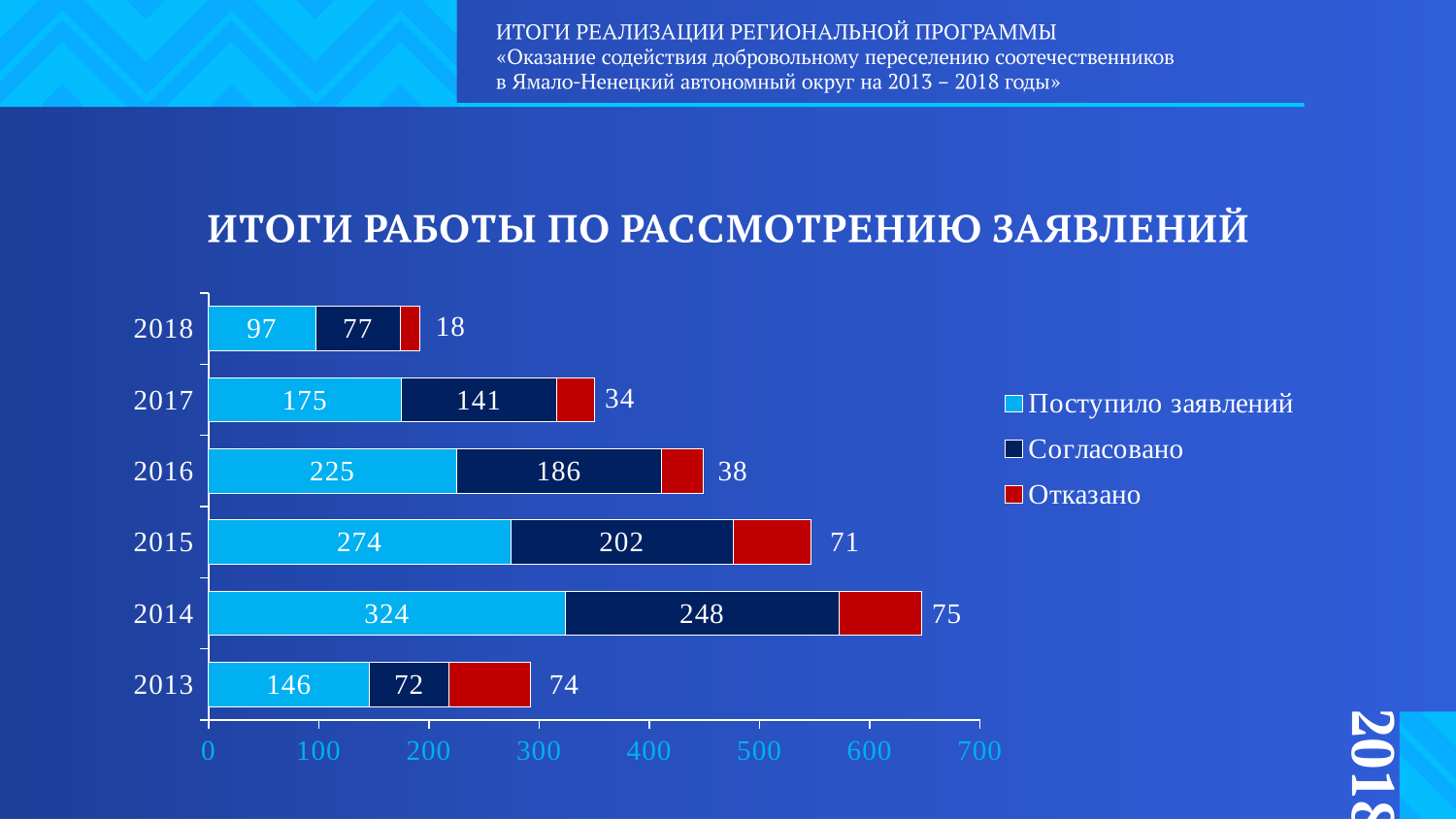
What is the value of «Поступило заявлений» for 2014? 324 Which is larger: «Отказано» in 2013 or «Отказано» in 2017? 2013 How many series does the legend list? 3 What is the value of «Отказано» for 2018? 18 Which series is shown in red in the legend? Отказано Which year has the highest value of «Поступило заявлений»? 2014 What kind of chart is shown on the slide? Stacked bar chart How many years (categories) are shown on the chart? 6 What is the difference between «Поступило заявлений» and «Согласовано» in 2015? 72 Which year has the lowest value of «Согласовано»? 2013 What is the total of the stacked bar for 2014? 647 What is the value of «Согласовано» for 2016? 186